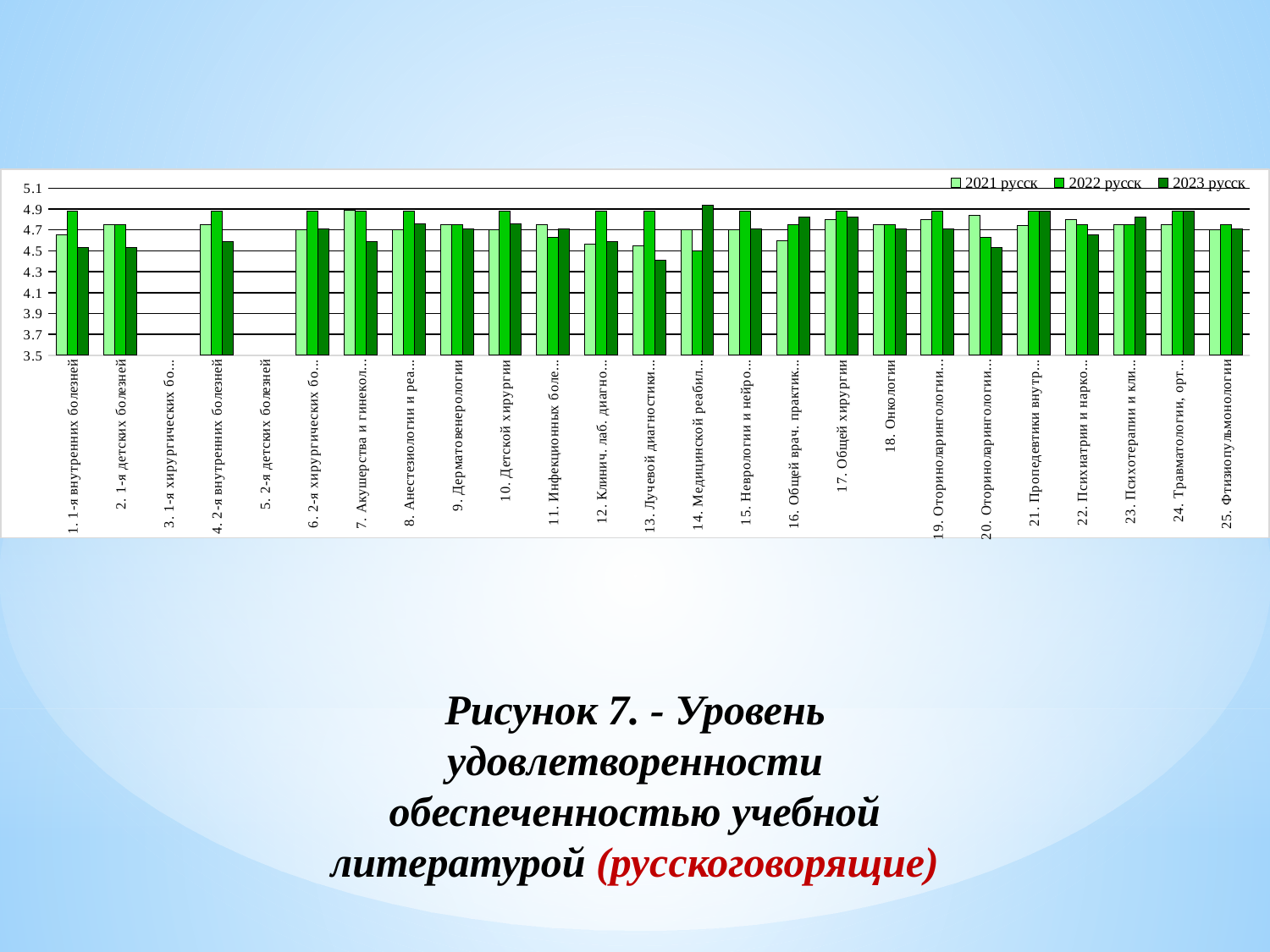
How many series does the legend list? 3 Is the 2023 русск value for "14. Медицинской реабил..." greater or less than 4.7? greater What are the three series named in the legend? 2021 русск, 2022 русск, 2023 русск Is the 2022 русск value for "7. Акушерства и гинекол..." greater or less than 4.7? greater For "14. Медицинской реабил...", which series has the highest value? 2023 русск Which two categories have no bars plotted? 3. 1-я хирургических бо... and 5. 2-я детских болезней What kind of chart is shown on the slide? bar chart Is the 2021 русск value for "12. Клинич. лаб. диагно..." greater or less than 4.7? less For "1. 1-я внутренних болезней", which is larger: the 2022 русск value or the 2023 русск value? 2022 русск How many categories are labelled along the x axis? 25